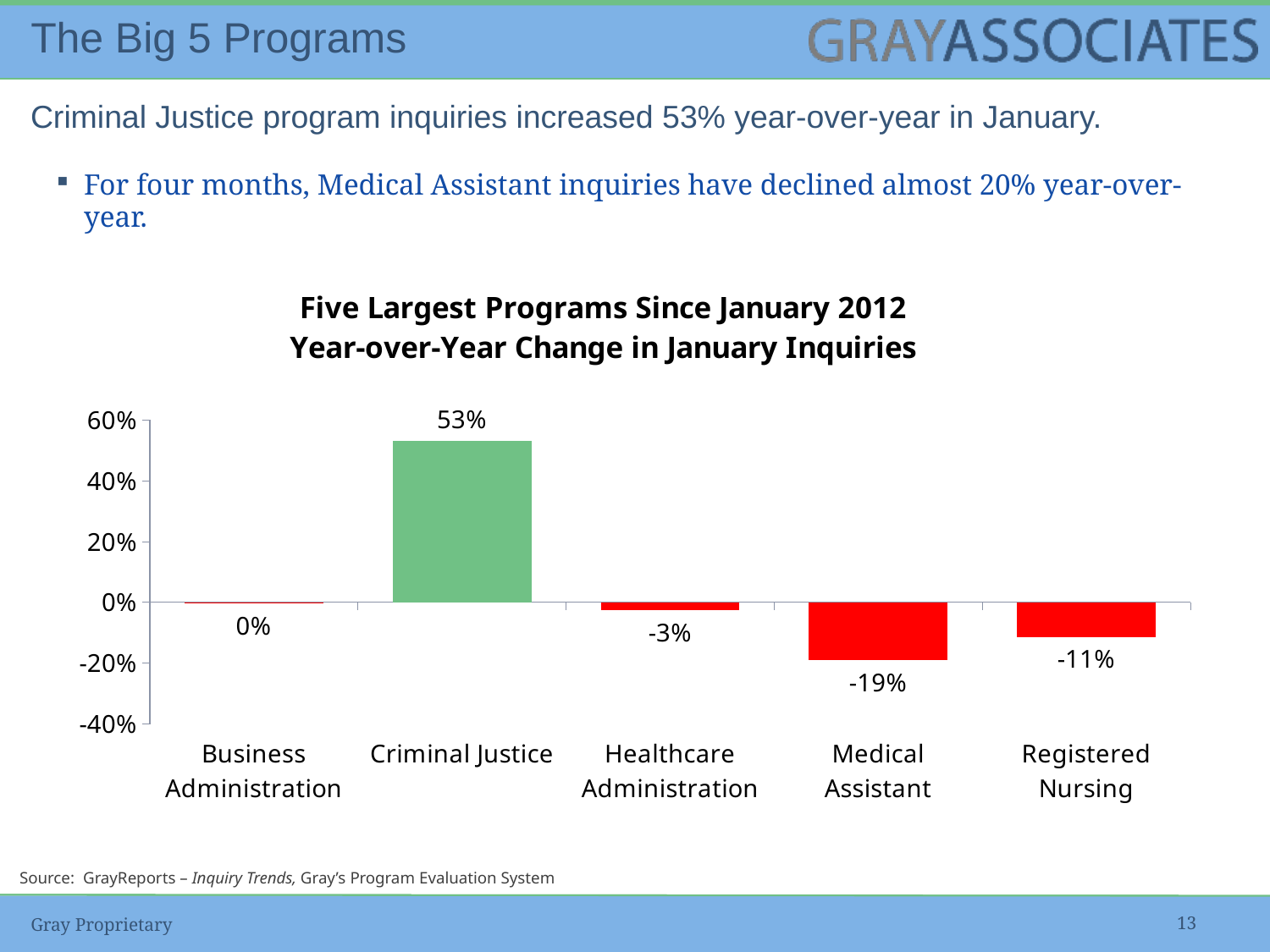
Which program has the highest year-over-year change in January inquiries? Criminal Justice What is the year-over-year change in January inquiries for Healthcare Administration? -3% How many programs are shown in the chart? 5 What is the year-over-year change in January inquiries for Registered Nursing? -11% What colour is the bar for Criminal Justice? Green Which has a larger year-over-year change in January inquiries, Healthcare Administration or Registered Nursing? Healthcare Administration What kind of chart is shown on the slide? Bar chart What is the year-over-year change in January inquiries for Criminal Justice? 53% Which program has the lowest year-over-year change in January inquiries? Medical Assistant What is the year-over-year change in January inquiries for Medical Assistant? -19% What is the difference between the year-over-year change for Criminal Justice and Medical Assistant? 72 percentage points What is the title of the chart? Five Largest Programs Since January 2012 Year-over-Year Change in January Inquiries